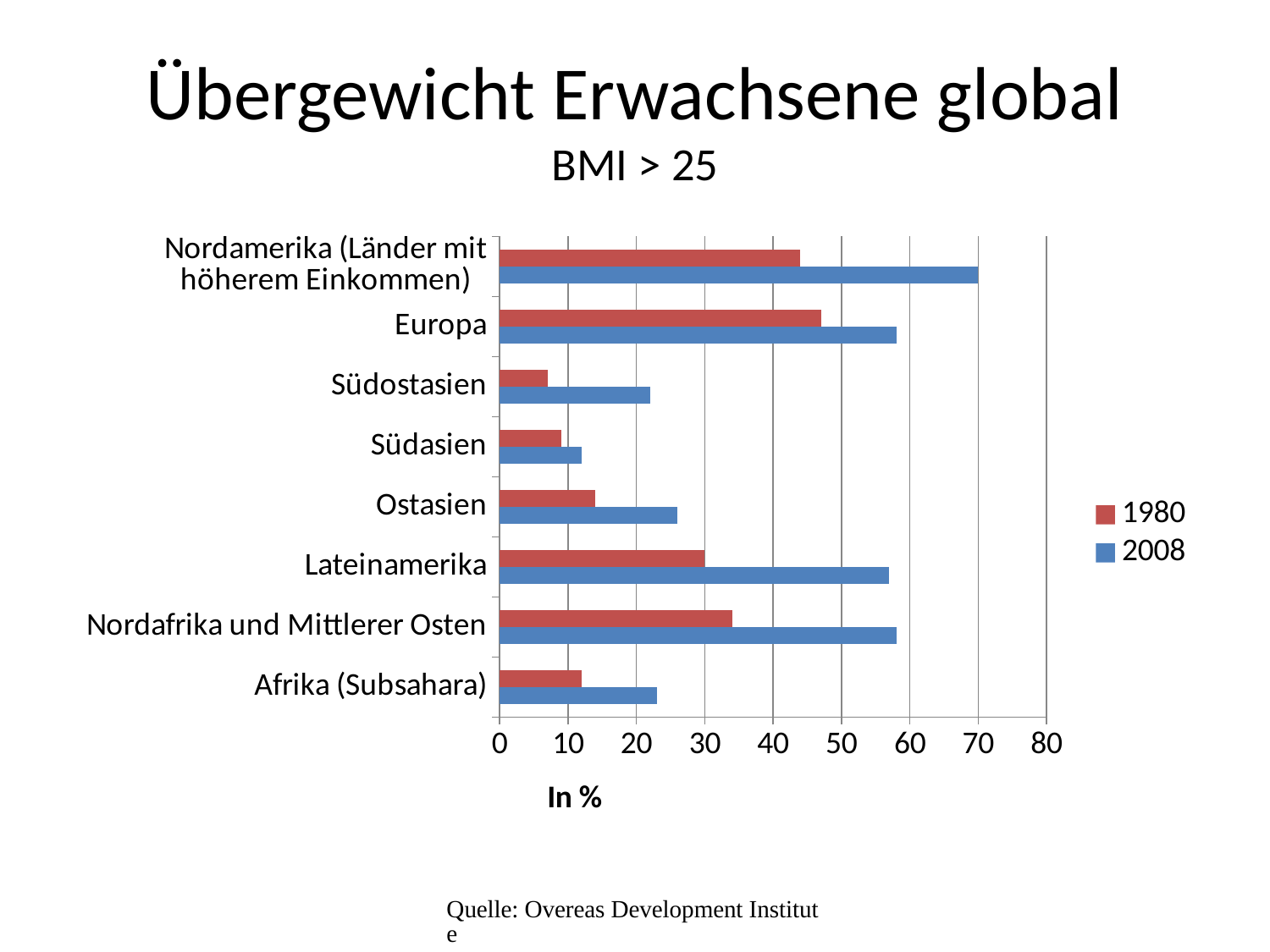
Is the 2008 value for Lateinamerika greater or less than 50? greater Which region has the lowest value for 2008? Südasien Is the 1980 value for Südostasien greater or less than 10? less What label is shown on the horizontal axis of the chart? In % Is the 1980 value for Ostasien greater or less than 20? less How many series does the legend list? 2 What kind of chart is shown on the slide? bar chart Which region has the highest value for 2008? Nordamerika (Länder mit höherem Einkommen) Which is larger for 2008: Nordamerika (Länder mit höherem Einkommen) or Europa? Nordamerika (Länder mit höherem Einkommen) How many regions (categories) are plotted on the chart? 8 Which is larger for 1980: Lateinamerika or Ostasien? Lateinamerika